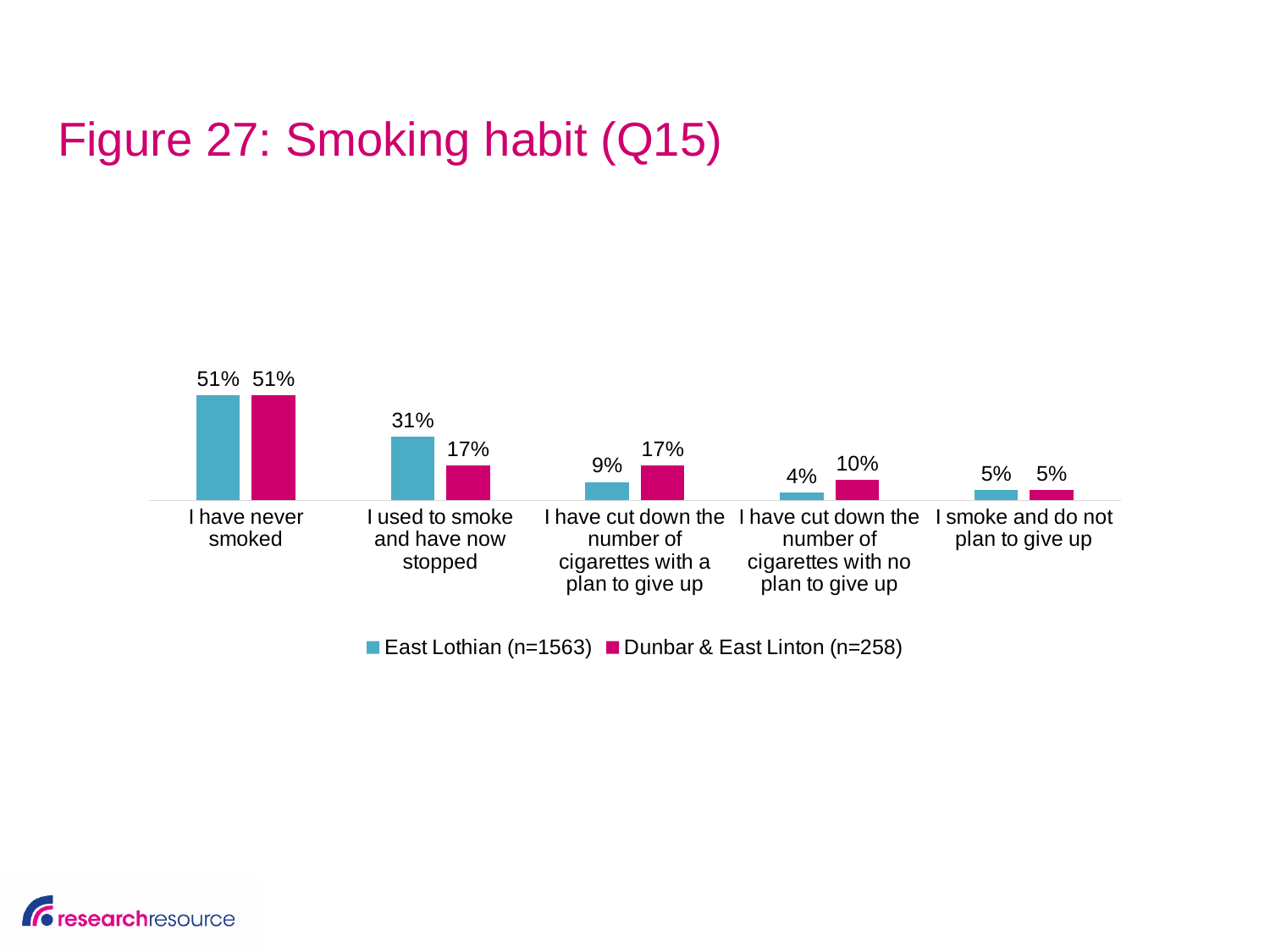
What is the value for East Lothian for 'I have cut down the number of cigarettes with no plan to give up'? 4% What kind of chart is shown on the slide? Bar chart Which category has the lowest value for East Lothian? I have cut down the number of cigarettes with no plan to give up For 'I have cut down the number of cigarettes with no plan to give up', which area has the larger value? Dunbar & East Linton How many categories are shown on the x axis? 5 What is the difference between East Lothian and Dunbar & East Linton for 'I used to smoke and have now stopped'? 14 percentage points How many series does the legend list? 2 What is the value for Dunbar & East Linton for 'I have cut down the number of cigarettes with a plan to give up'? 17% What percentage of East Lothian respondents said 'I have never smoked'? 51% Which category has the highest value for East Lothian? I have never smoked What is the sample size (n) for Dunbar & East Linton shown in the legend? 258 What percentage of Dunbar & East Linton respondents said 'I used to smoke and have now stopped'? 17%